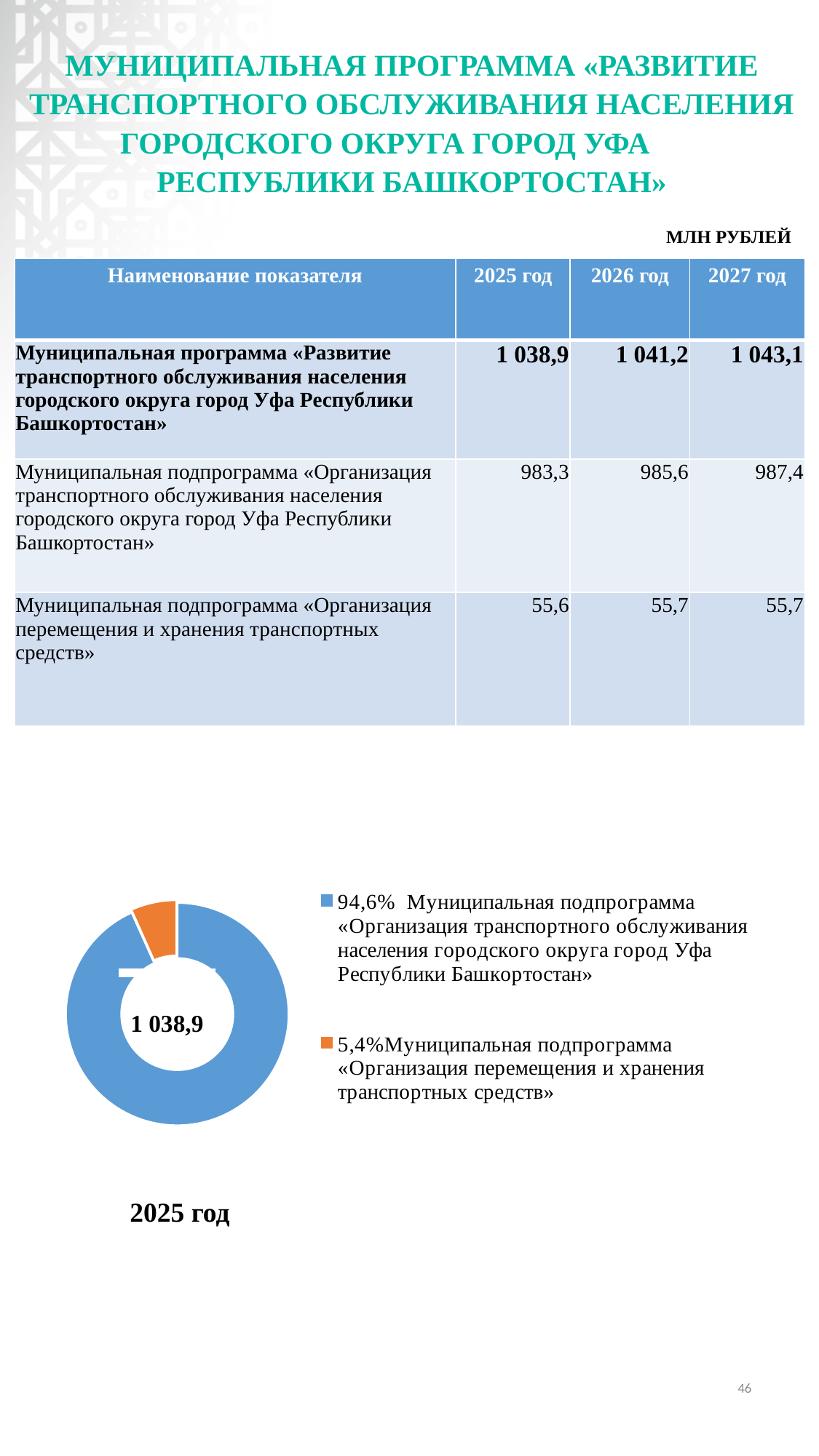
What kind of chart is shown on the slide? Pie (donut) chart Which slice of the pie chart is the largest? Муниципальная подпрограмма «Организация транспортного обслуживания населения городского округа город Уфа Республики Башкортостан» How many entries does the pie chart's legend list? 2 What colour is the slice for the subprogram «Организация перемещения и хранения транспортных средств» in the pie chart? Orange Which year does the pie chart represent? 2025 год How many slices does the pie chart have? 2 Which slice of the pie chart is the smallest? Муниципальная подпрограмма «Организация перемещения и хранения транспортных средств» What share of the pie chart does the subprogram «Организация перемещения и хранения транспортных средств» take? 5,4% What share of the pie chart does the subprogram «Организация транспортного обслуживания населения городского округа город Уфа Республики Башкортостан» take? 94,6% What is the difference in percentage points between the two slices of the pie chart? 89,2 Which is larger in the pie chart: the share for «Организация перемещения и хранения транспортных средств» or the share for «Организация транспортного обслуживания населения»? «Организация транспортного обслуживания населения» What value is printed in the centre of the donut chart? 1 038,9